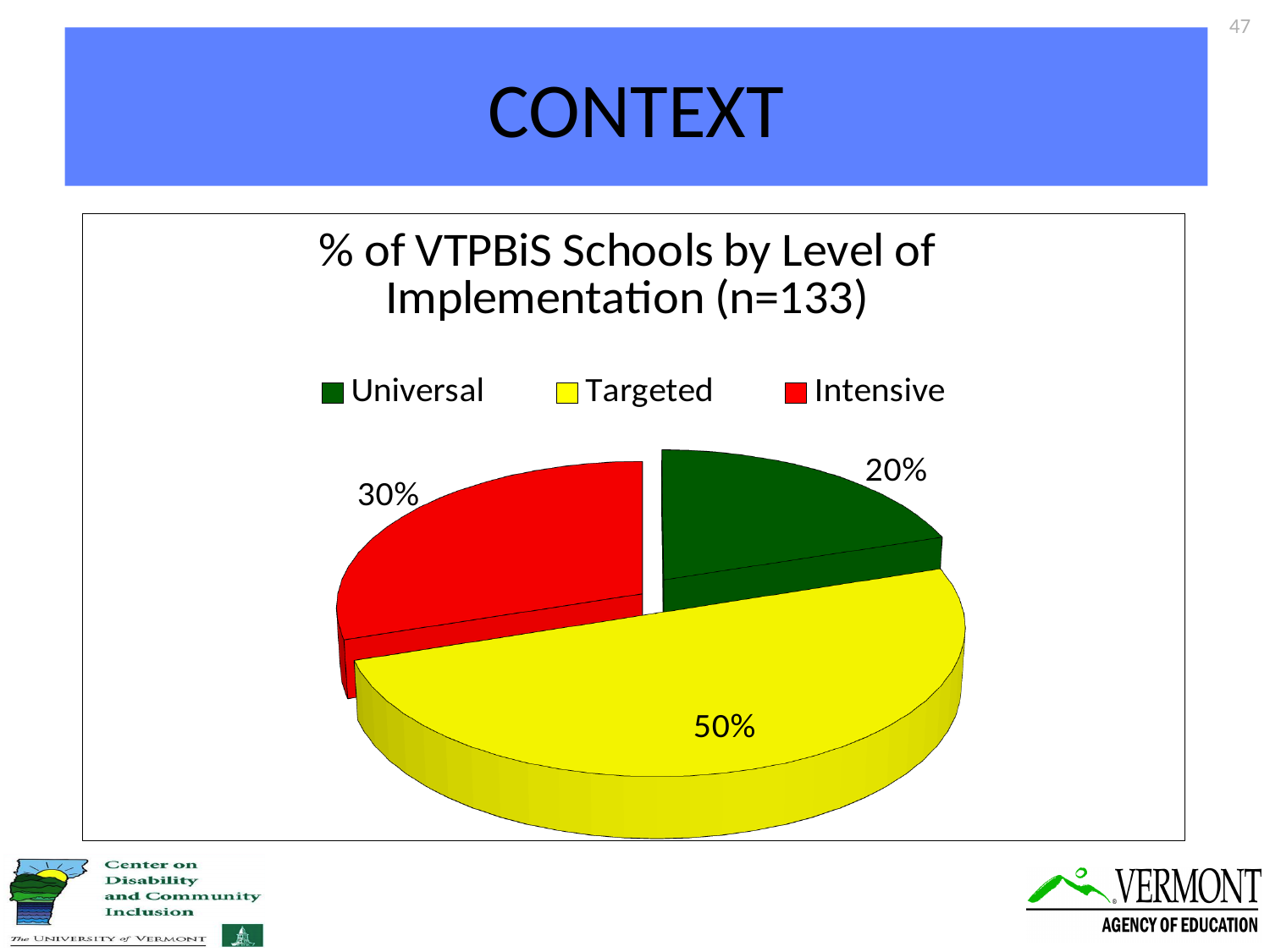
What percentage of VTPBiS schools are at the Intensive level of implementation? 30% Which slice is larger, Intensive or Universal? Intensive Which level of implementation has the largest share of VTPBiS schools? Targeted What is the difference in percentage points between the Targeted and Intensive slices? 20% What percentage of VTPBiS schools are at the Universal level of implementation? 20% How many entries does the legend list? 3 What colour is the Intensive slice in the pie chart? Red Which level of implementation has the smallest share of VTPBiS schools? Universal How many slices does the pie chart have? 3 What percentage of VTPBiS schools are at the Targeted level of implementation? 50% What kind of chart is shown on the slide? Pie chart What is the title of the chart? % of VTPBiS Schools by Level of Implementation (n=133)